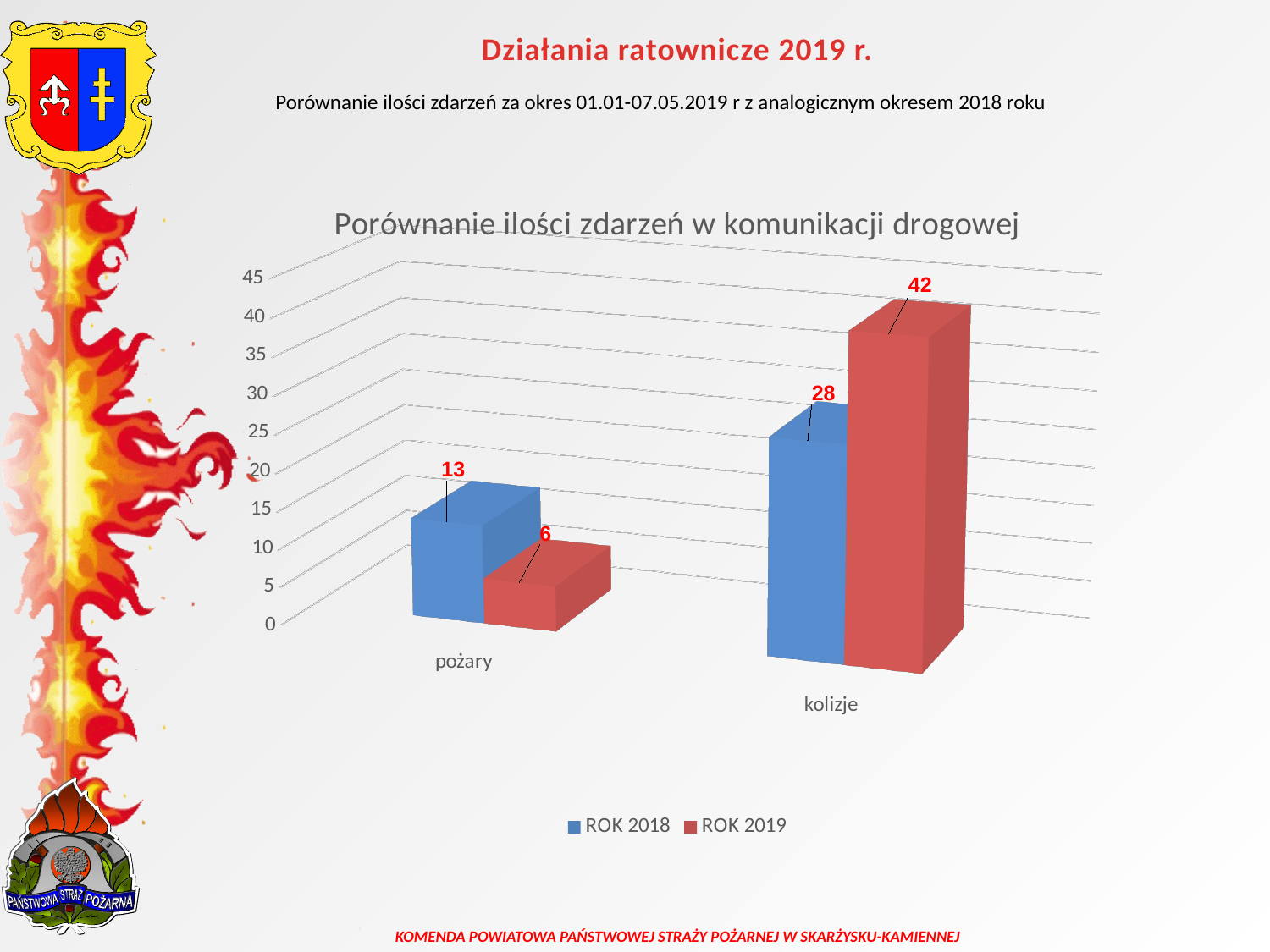
What is the value for ROK 2019 in the pożary category? 6 Which category has the lowest value for ROK 2019? pożary Which is larger for pożary: ROK 2018 or ROK 2019? ROK 2018 What is the value for ROK 2018 in the pożary category? 13 What is the difference between ROK 2018 and ROK 2019 for pożary? 7 Which category has the highest value for ROK 2019? kolizje How many categories are shown on the x axis? 2 What is the difference between ROK 2019 and ROK 2018 for kolizje? 14 What is the value for ROK 2019 in the kolizje category? 42 What is the value for ROK 2018 in the kolizje category? 28 What kind of chart is shown on the slide? bar chart How many series does the legend list? 2